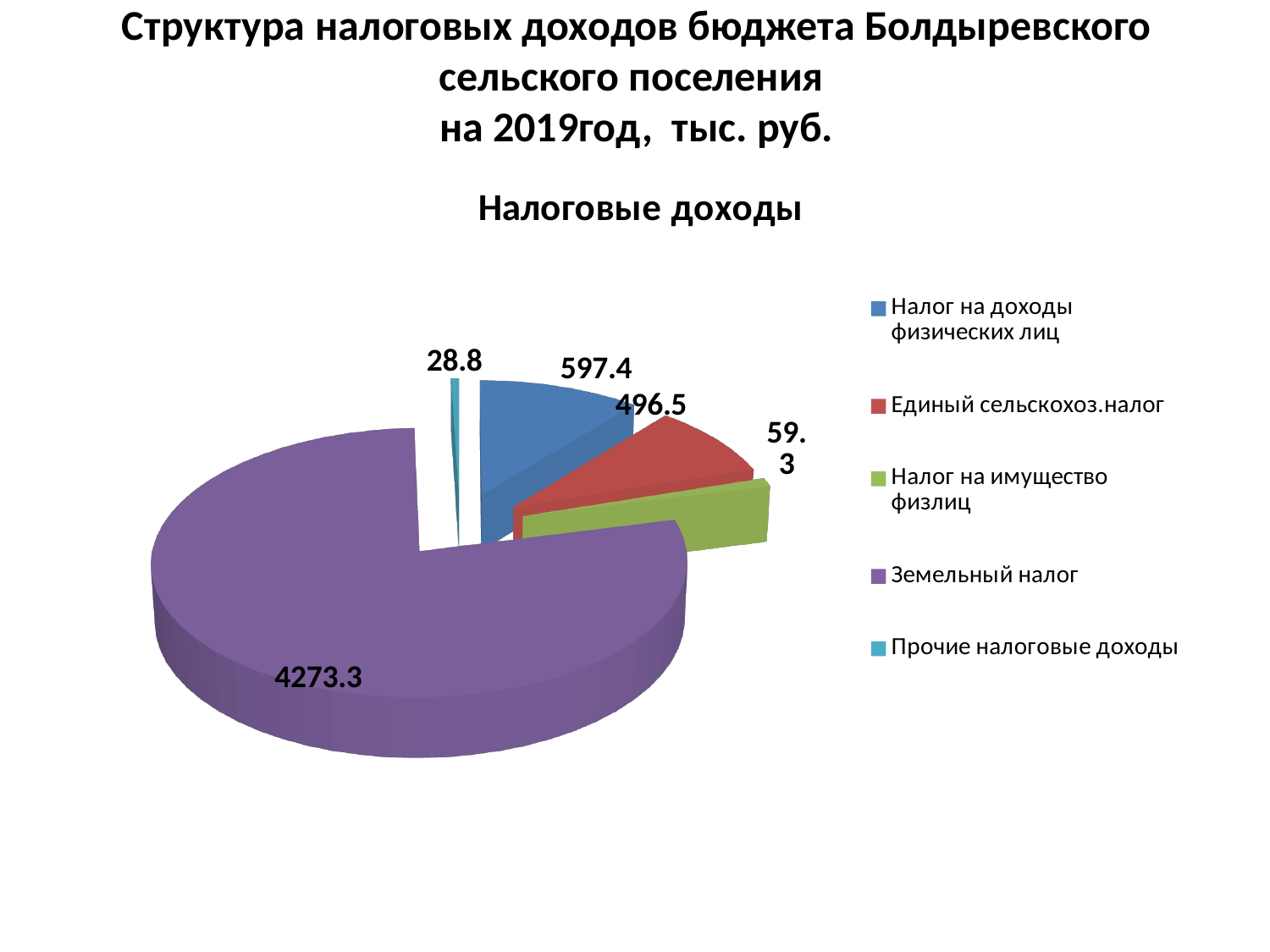
Which category has the largest slice of the pie? Земельный налог What is the value for Налог на доходы физических лиц? 597.4 What is the title of the chart? Налоговые доходы What is the value for Земельный налог? 4273.3 Which is larger, the value for Налог на имущество физлиц or the value for Прочие налоговые доходы? Налог на имущество физлиц What is the difference between the values for Налог на имущество физлиц and Прочие налоговые доходы? 30.5 How many categories does the legend list? 5 What is the value for Единый сельскохоз.налог? 496.5 What kind of chart is shown on the slide? Pie chart What is the difference between the values for Налог на доходы физических лиц and Единый сельскохоз.налог? 100.9 Which category has the smallest slice of the pie? Прочие налоговые доходы What is the value for Прочие налоговые доходы? 28.8